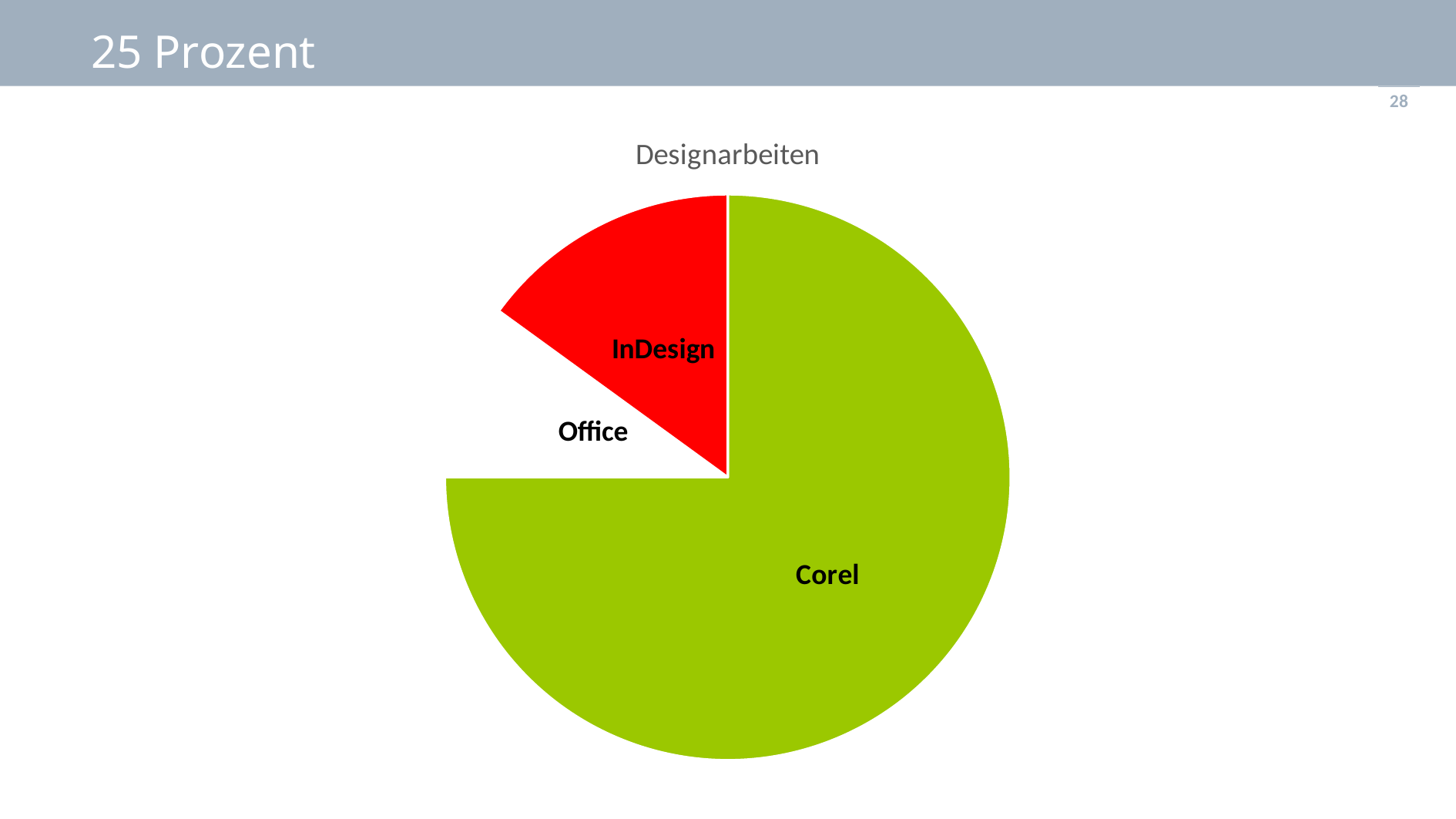
How many slices does the pie chart have? 3 Which slice is the largest in the pie chart? Corel Which slice is larger, Corel or InDesign? Corel Which slice is larger, InDesign or Office? InDesign Which slice is the smallest in the pie chart? Office What colour is the Corel slice? green What kind of chart is shown on the slide? pie chart Does the Corel slice take up more or less than half of the pie? more What is the title of the chart? Designarbeiten